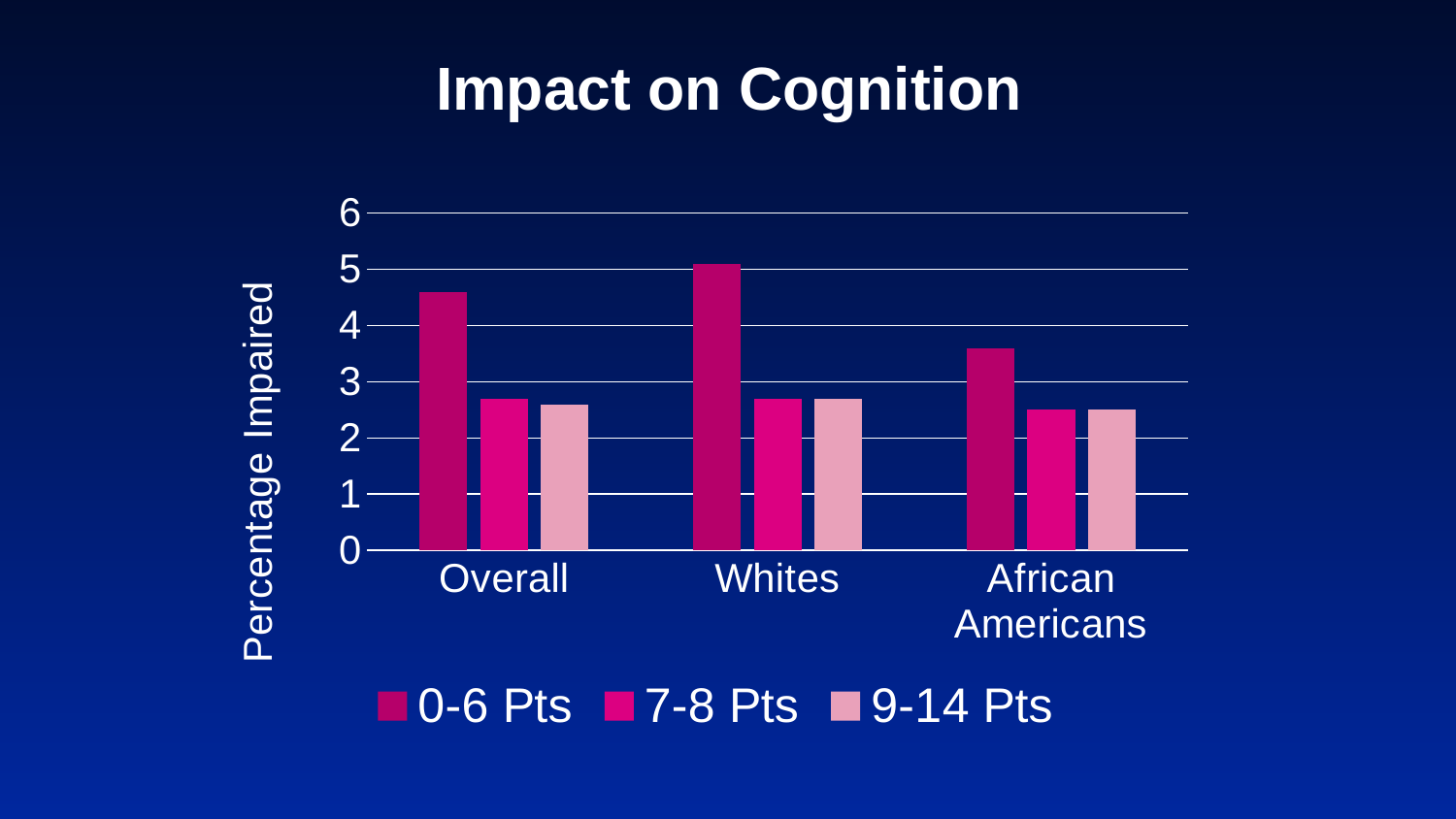
Is the 0-6 Pts value for Overall greater or less than 4? greater Which is larger: the 0-6 Pts value for Whites or the 0-6 Pts value for Overall? Whites Within the Overall category, which series has the highest value? 0-6 Pts Which category has the highest value for the 0-6 Pts series? Whites How many categories are shown on the x axis? 3 Which category has the lowest value for the 0-6 Pts series? African Americans How many series does the legend list? 3 What is the title of the chart? Impact on Cognition What is the label on the vertical axis? Percentage Impaired Is the 0-6 Pts value for African Americans greater or less than 4? less Is the 7-8 Pts value for Whites greater or less than 3? less What type of chart is shown on the slide? bar chart